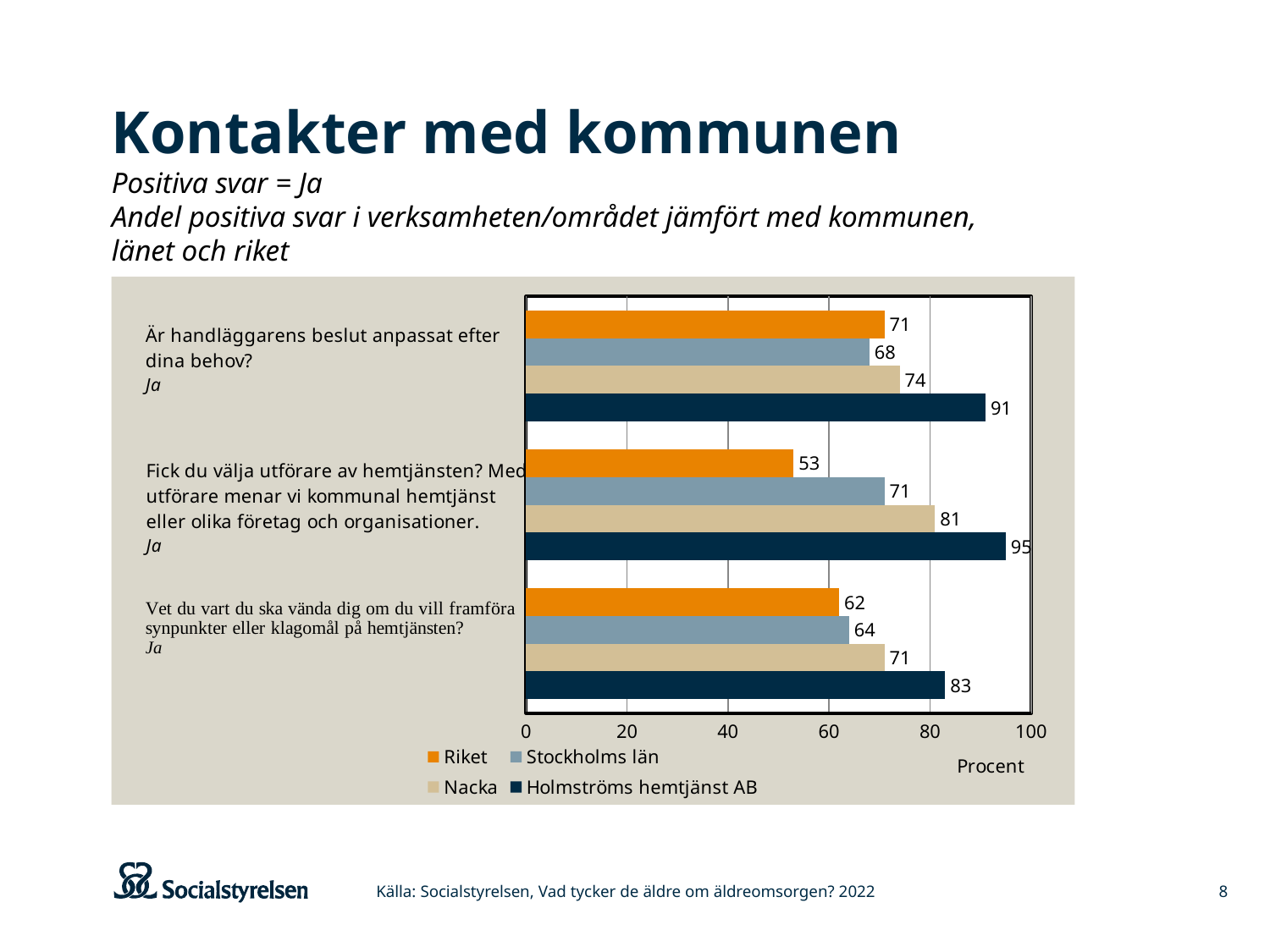
What kind of chart is shown on the slide? Bar chart What is the difference between Holmströms hemtjänst AB and Riket on the question "Fick du välja utförare av hemtjänsten?"? 42 Which series has the highest value on the question "Fick du välja utförare av hemtjänsten?"? Holmströms hemtjänst AB Which is larger on the question "Är handläggarens beslut anpassat efter dina behov?": Nacka or Stockholms län? Nacka What is the value for Riket on the question "Fick du välja utförare av hemtjänsten?"? 53 What is the value for Stockholms län on the question "Är handläggarens beslut anpassat efter dina behov?"? 68 What is the value for Nacka on the question "Vet du vart du ska vända dig om du vill framföra synpunkter eller klagomål på hemtjänsten?"? 71 What is the value for Holmströms hemtjänst AB on the question "Är handläggarens beslut anpassat efter dina behov?"? 91 What unit is shown on the horizontal axis of the chart? Procent How many series does the legend list? 4 Which series has the lowest value on the question "Vet du vart du ska vända dig om du vill framföra synpunkter eller klagomål på hemtjänsten?"? Riket How many questions (categories) are shown on the chart? 3